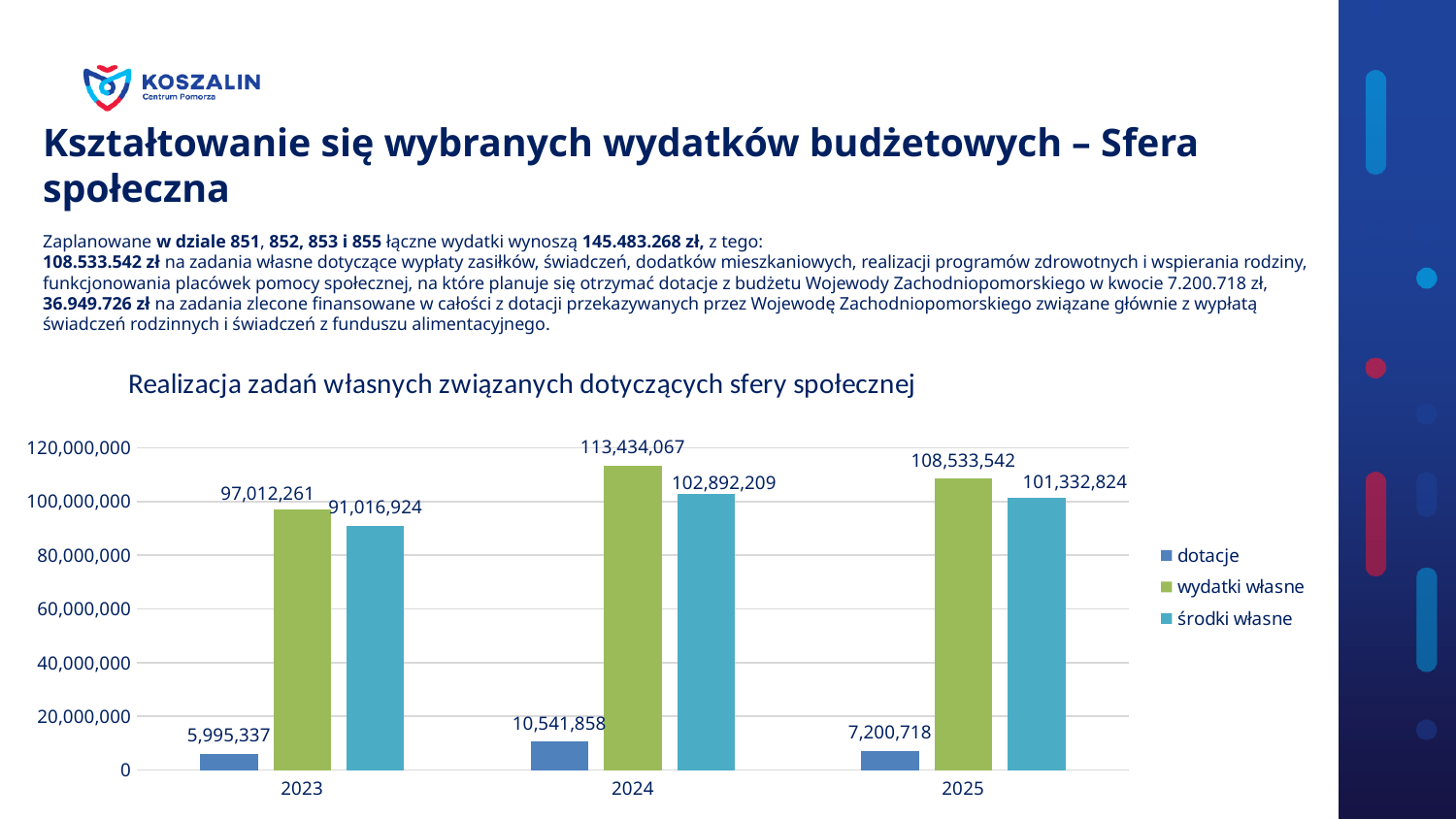
How many years are shown on the x axis of the chart? 3 Is the value of środki własne for 2023 greater or less than 100,000,000? less What is the difference between wydatki własne in 2024 and in 2023? 16,421,806 What is the value of dotacje for 2023? 5,995,337 What is the value of wydatki własne for 2024? 113,434,067 In which year is the value of wydatki własne the highest? 2024 What is the title of the chart? Realizacja zadań własnych związanych dotyczących sfery społecznej How many series does the chart legend list? 3 What is the value of środki własne for 2025? 101,332,824 Which is larger in 2025: wydatki własne or środki własne? wydatki własne What type of chart is shown on the slide? bar chart In which year is the value of dotacje the lowest? 2023